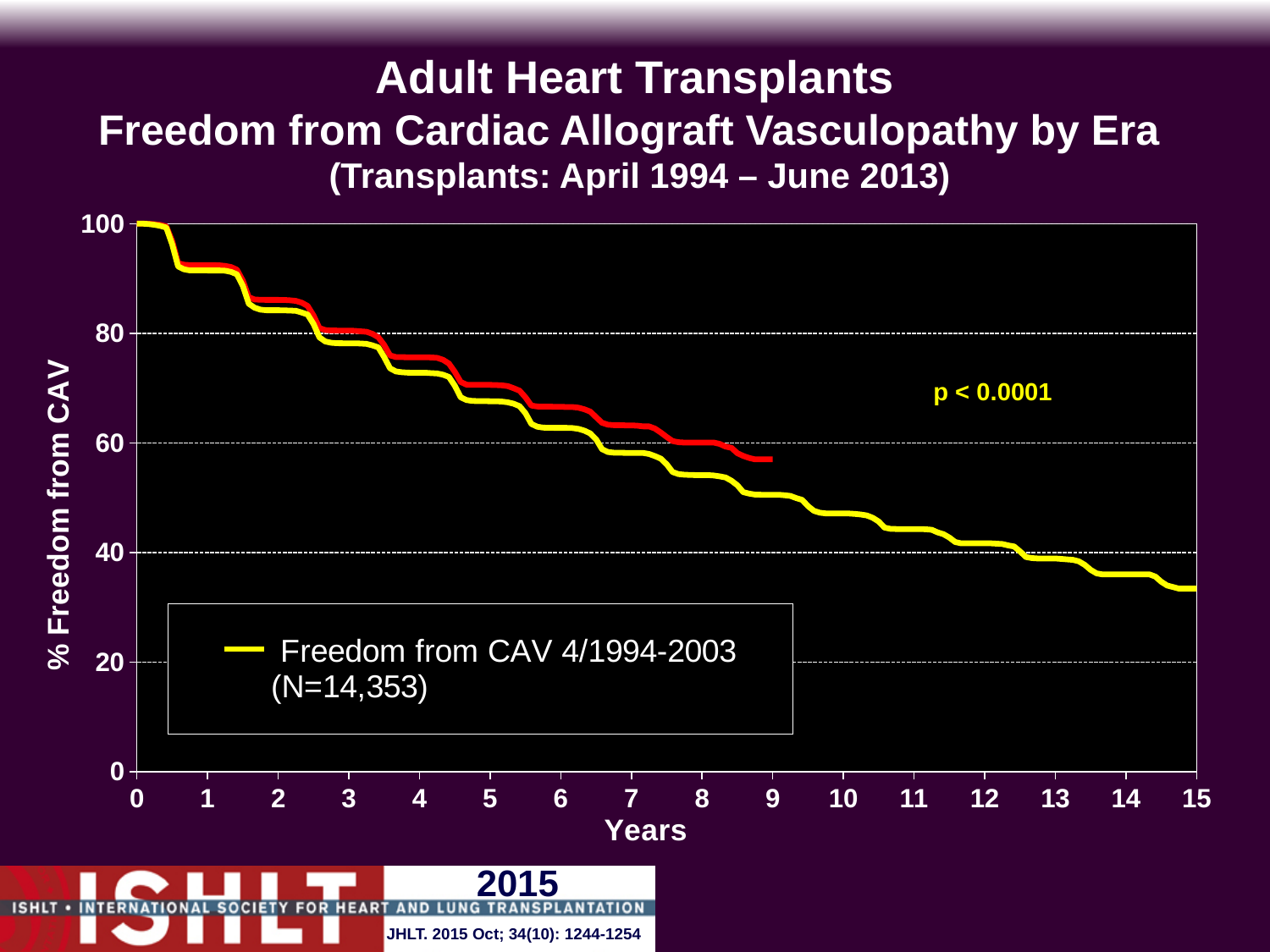
Is the value of the Freedom from CAV 4/1994-2003 line at year 5 greater or less than 60? greater Is the value of the Freedom from CAV 4/1994-2003 line at year 2 greater or less than 80? greater What is the label of the series shown in the legend? Freedom from CAV 4/1994-2003 (N=14,353) What kind of chart is shown on the slide? line chart How many series does the legend list? 1 Is the value of the Freedom from CAV 4/1994-2003 line at year 15 greater or less than 40? less What is the value of the Freedom from CAV 4/1994-2003 line at year 0? 100 At year 5, which line is higher, the red line or the yellow line? the red line Do the values of the Freedom from CAV 4/1994-2003 line rise or fall as years increase? fall What is the title of the chart on the slide? Adult Heart Transplants Freedom from Cardiac Allograft Vasculopathy by Era (Transplants: April 1994 – June 2013) What is the p-value printed on the chart? p < 0.0001